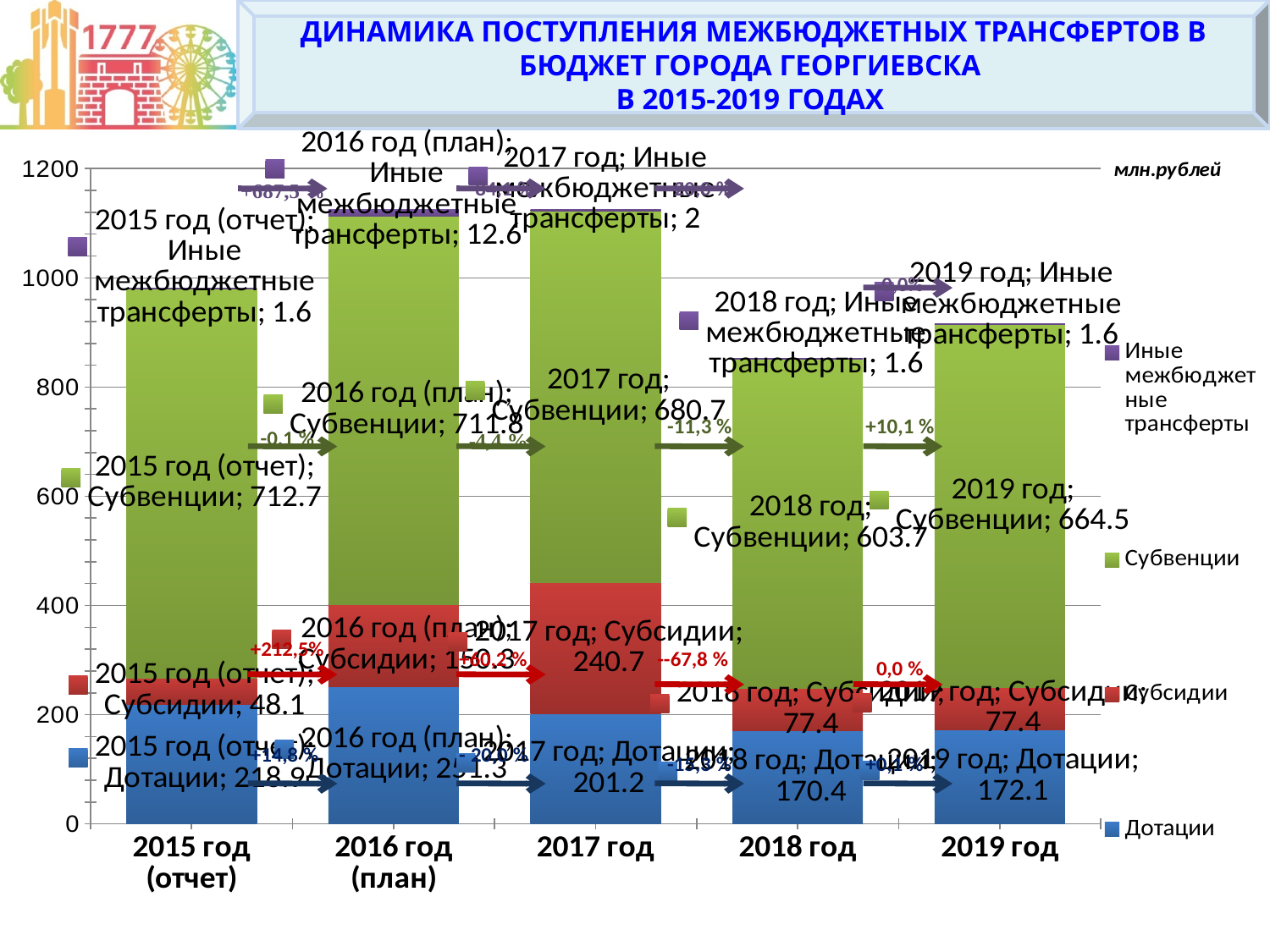
How many year categories are shown on the x axis? 5 What is the difference between the Субвенции values for 2019 год and 2018 год? 60.8 In which year is the Субвенции value the lowest? 2018 год Which is larger, the Дотации value for 2017 год or for 2019 год? 2017 год What is the value of Дотации for 2018 год? 170.4 In which year is the Субсидии value the highest? 2017 год What is the total of the stacked bar for 2018 год? 853.1 How many series does the legend list? 4 What is the value of Субвенции for 2017 год? 680.7 What kind of chart is shown on the slide? Stacked bar chart What is the value of Субсидии for 2017 год? 240.7 What is the value of Иные межбюджетные трансферты for 2016 год (план)? 12.6